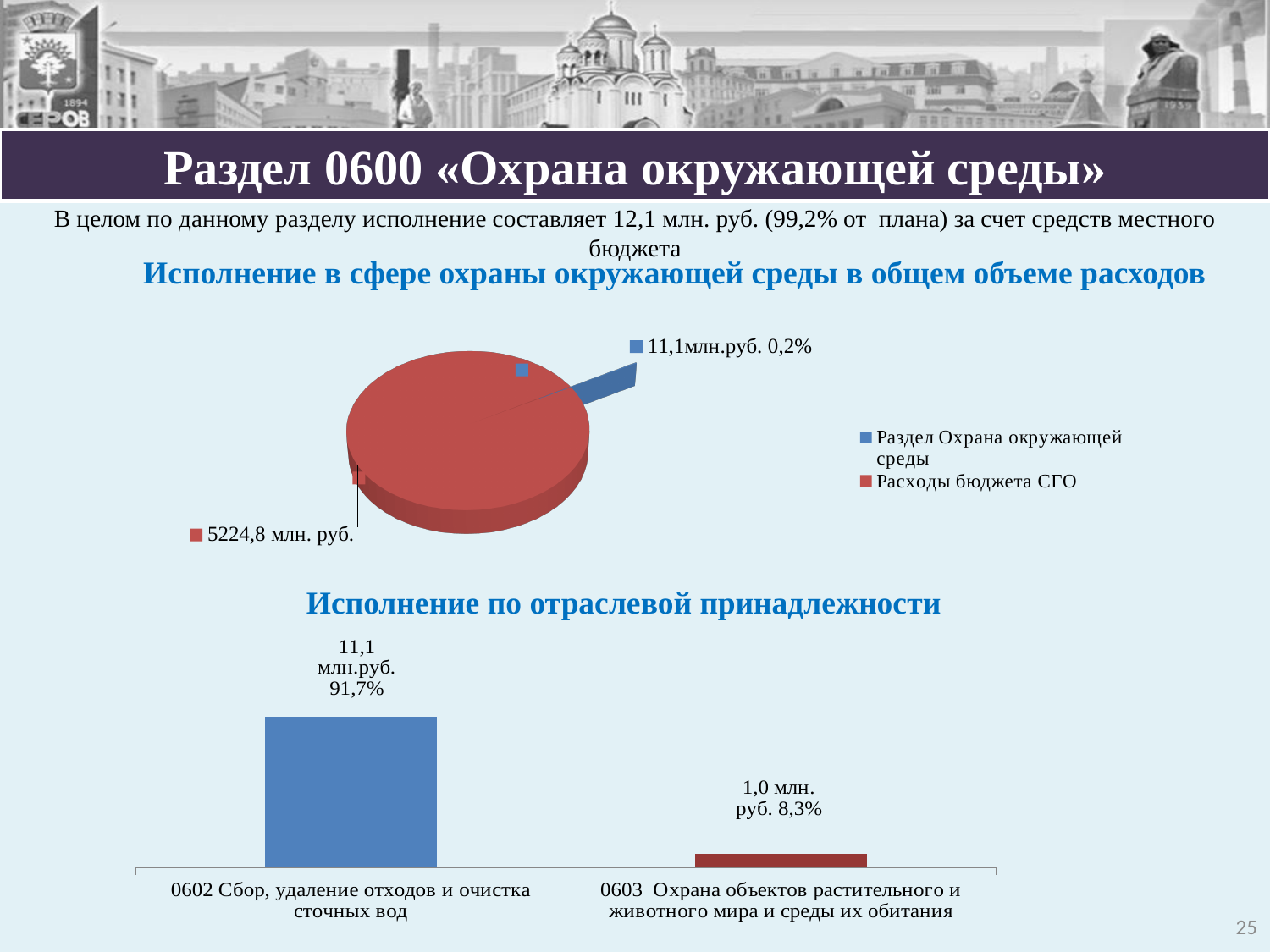
In the bar chart «Исполнение по отраслевой принадлежности», what value is shown for «0602 Сбор, удаление отходов и очистка сточных вод»? 11,1 млн.руб. In the pie chart, what value is shown for «Расходы бюджета СГО»? 5224,8 млн. руб. How many categories are shown in the bar chart «Исполнение по отраслевой принадлежности»? 2 In the pie chart, what share of the total does «Раздел Охрана окружающей среды» represent? 0,2% What kind of chart is the bottom chart titled «Исполнение по отраслевой принадлежности»? bar chart How many entries does the legend of the pie chart list? 2 What kind of chart is the top chart titled «Исполнение в сфере охраны окружающей среды в общем объеме расходов»? pie chart In the bar chart «Исполнение по отраслевой принадлежности», what value is shown for «0603 Охрана объектов растительного и животного мира и среды их обитания»? 1,0 млн. руб. In the pie chart, what value is shown for «Раздел Охрана окружающей среды»? 11,1 млн.руб. In the bar chart «Исполнение по отраслевой принадлежности», which category has the highest value? 0602 Сбор, удаление отходов и очистка сточных вод In the pie chart, which slice is larger: «Раздел Охрана окружающей среды» or «Расходы бюджета СГО»? Расходы бюджета СГО In the bar chart «Исполнение по отраслевой принадлежности», what percentage is shown for «0603 Охрана объектов растительного и животного мира и среды их обитания»? 8,3%